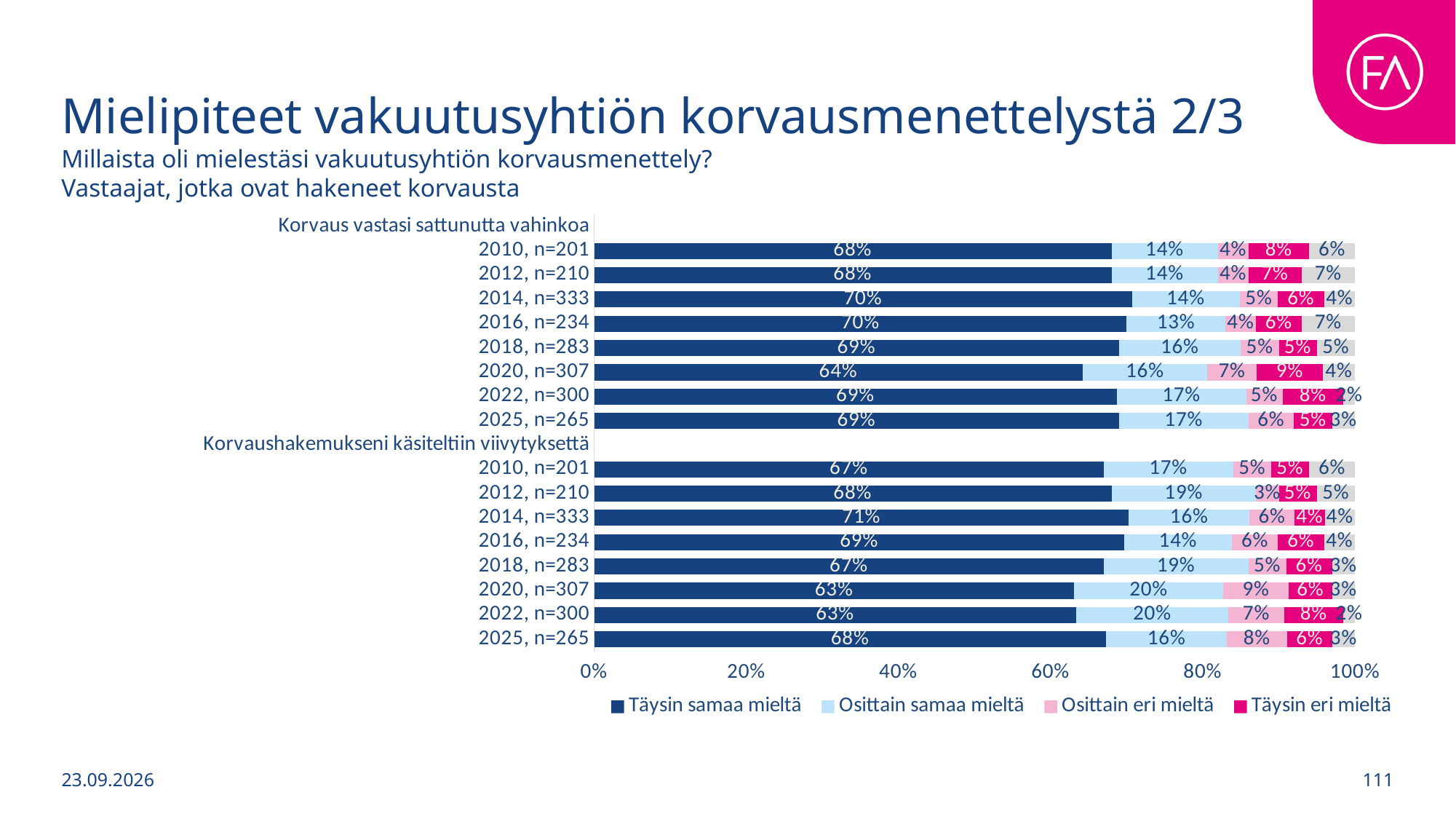
Which is larger: the 'Täysin samaa mieltä' share for 2025, n=265 in 'Korvaus vastasi sattunutta vahinkoa' or in 'Korvaushakemukseni käsiteltiin viivytyksettä'? Korvaus vastasi sattunutta vahinkoa (69%) In the group 'Korvaushakemukseni käsiteltiin viivytyksettä', which year has the highest 'Täysin samaa mieltä' share? 2014, n=333 In the group 'Korvaus vastasi sattunutta vahinkoa', what is the 'Täysin samaa mieltä' share for 2020, n=307? 64% What is the last entry in the chart legend? Täysin eri mieltä How many year rows are shown in the group 'Korvaushakemukseni käsiteltiin viivytyksettä'? 8 In the group 'Korvaushakemukseni käsiteltiin viivytyksettä', what is the 'Osittain eri mieltä' share for 2020, n=307? 9% In the group 'Korvaushakemukseni käsiteltiin viivytyksettä', what is the 'Osittain samaa mieltä' share for 2022, n=300? 20% In the group 'Korvaus vastasi sattunutta vahinkoa', what is the 'Täysin eri mieltä' share for 2020, n=307? 9% In the group 'Korvaus vastasi sattunutta vahinkoa', what is the difference between the 'Täysin samaa mieltä' shares for 2014, n=333 and 2020, n=307? 6 percentage points In the group 'Korvaus vastasi sattunutta vahinkoa', which year has the lowest 'Täysin samaa mieltä' share? 2020, n=307 What type of chart is shown on the slide? Stacked bar chart How many series does the legend list? 4